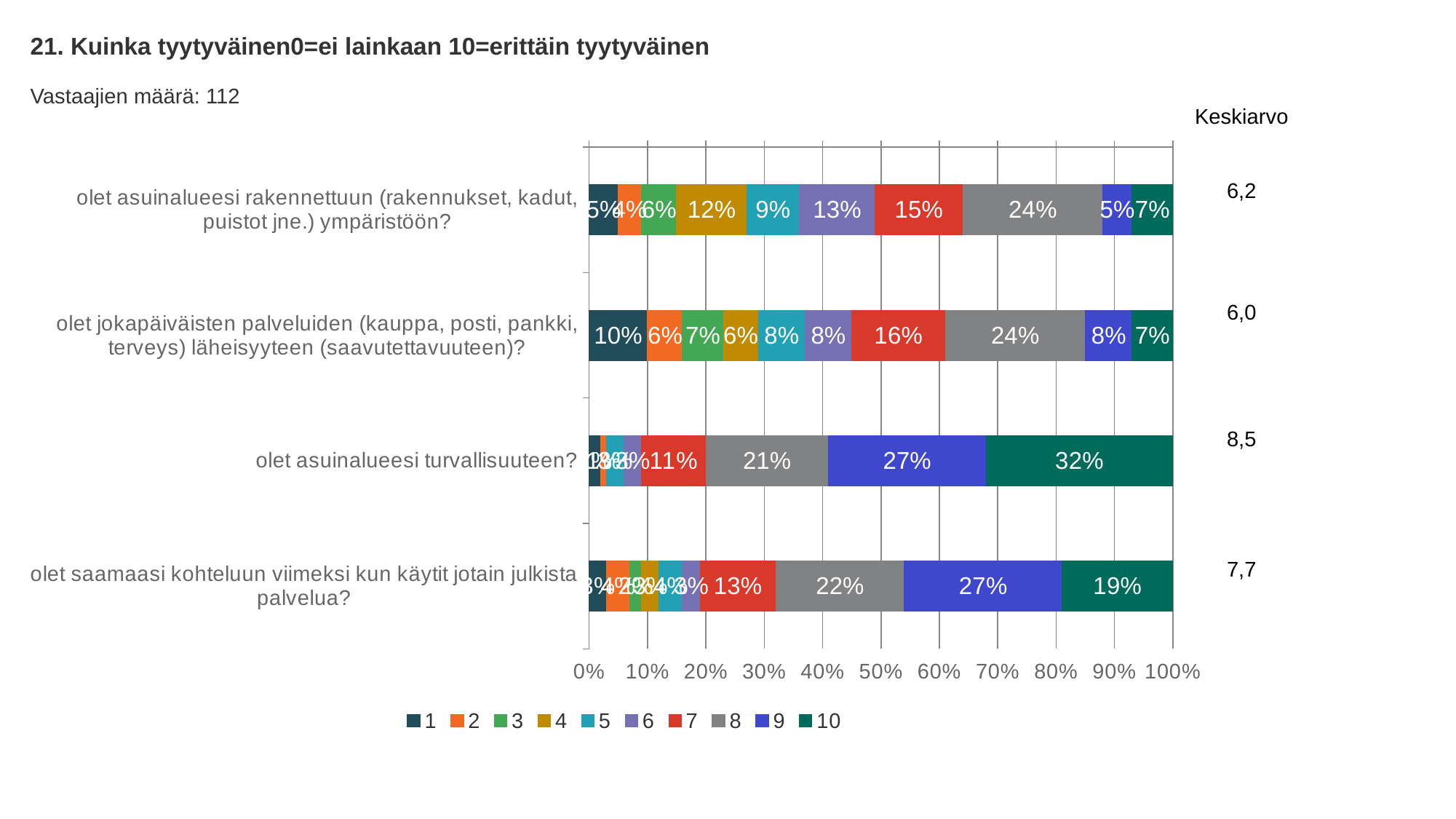
Is the share of rating 10 larger for 'olet asuinalueesi turvallisuuteen?' or for 'olet saamaasi kohteluun viimeksi kun käytit jotain julkista palvelua?' olet asuinalueesi turvallisuuteen? Which rating has the largest share for 'olet asuinalueesi turvallisuuteen?' 10 How many categories (questions) are plotted in the chart? 4 What is the Keskiarvo (mean) shown for 'olet asuinalueesi turvallisuuteen?' 8,5 What share of respondents gave a rating of 9 for 'olet saamaasi kohteluun viimeksi kun käytit jotain julkista palvelua?' 27% What share of respondents gave a rating of 1 for 'olet jokapäiväisten palveluiden (kauppa, posti, pankki, terveys) läheisyyteen (saavutettavuuteen)?' 10% What is the difference between the share of rating 7 for 'olet jokapäiväisten palveluiden' (16%) and for 'olet asuinalueesi rakennettuun ympäristöön' (15%)? 1% How many series does the legend list? 10 What share of respondents gave a rating of 8 for 'olet jokapäiväisten palveluiden (kauppa, posti, pankki, terveys) läheisyyteen (saavutettavuuteen)?' 24% What kind of chart is shown on the slide? stacked bar chart Which rating has the largest share for 'olet asuinalueesi rakennettuun (rakennukset, kadut, puistot jne.) ympäristöön?' 8 What share of respondents gave a rating of 10 for 'olet asuinalueesi turvallisuuteen?' 32%